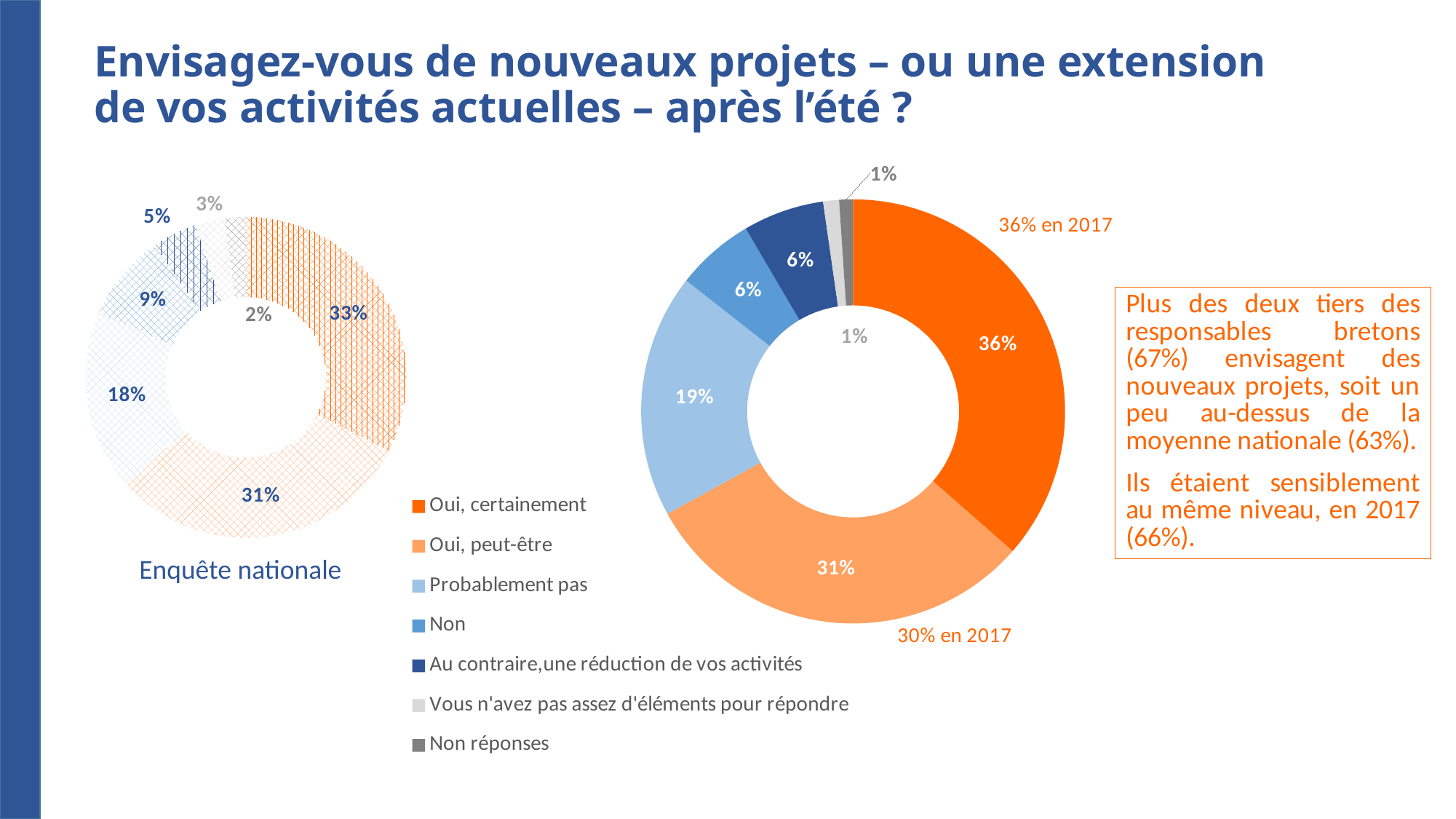
In the right chart, what is the share for 'Oui, certainement'? 36% What is the title shown under the left chart? Enquête nationale In the left chart (Enquête nationale), what is the share for 'Non'? 9% What kind of chart is the right chart? Donut (pie) chart In the right chart, what is the share for 'Probablement pas'? 19% In the right chart, which category has the largest share? Oui, certainement In the left chart (Enquête nationale), which is larger: 'Probablement pas' or 'Non'? Probablement pas In the left chart (Enquête nationale), which category has the smallest share? Non réponses In the left chart (Enquête nationale), what is the share for 'Oui, certainement'? 33% What is the difference between the 'Oui, certainement' share in the right chart and in the left chart (Enquête nationale)? 3 percentage points In the right chart, what is the combined share of 'Oui, certainement' and 'Oui, peut-être'? 67% How many entries does the legend list? 7